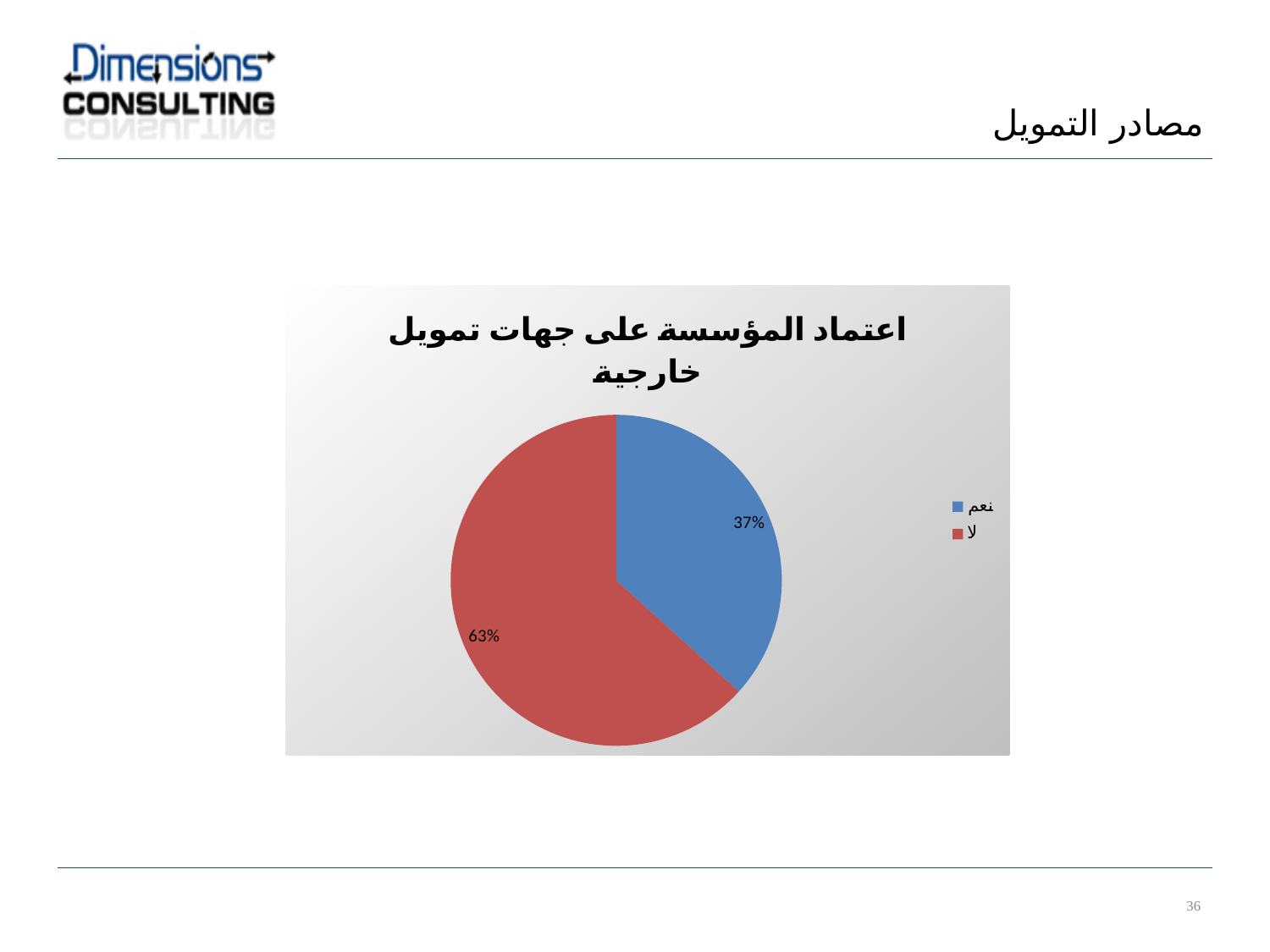
What share of the pie does the "نعم" slice represent? 37% Which slice is the largest in the pie chart? لا Which slice is the smallest in the pie chart? نعم What is the difference in percentage points between the "لا" slice and the "نعم" slice? 26 How many entries does the legend list? 2 What share of the pie does the "لا" slice represent? 63% Which is larger, the "نعم" slice or the "لا" slice? لا How many slices does the pie chart have? 2 What kind of chart is shown on the slide? pie chart What is the title of the chart? اعتماد المؤسسة على جهات تمويل خارجية What colour is the "لا" slice? red